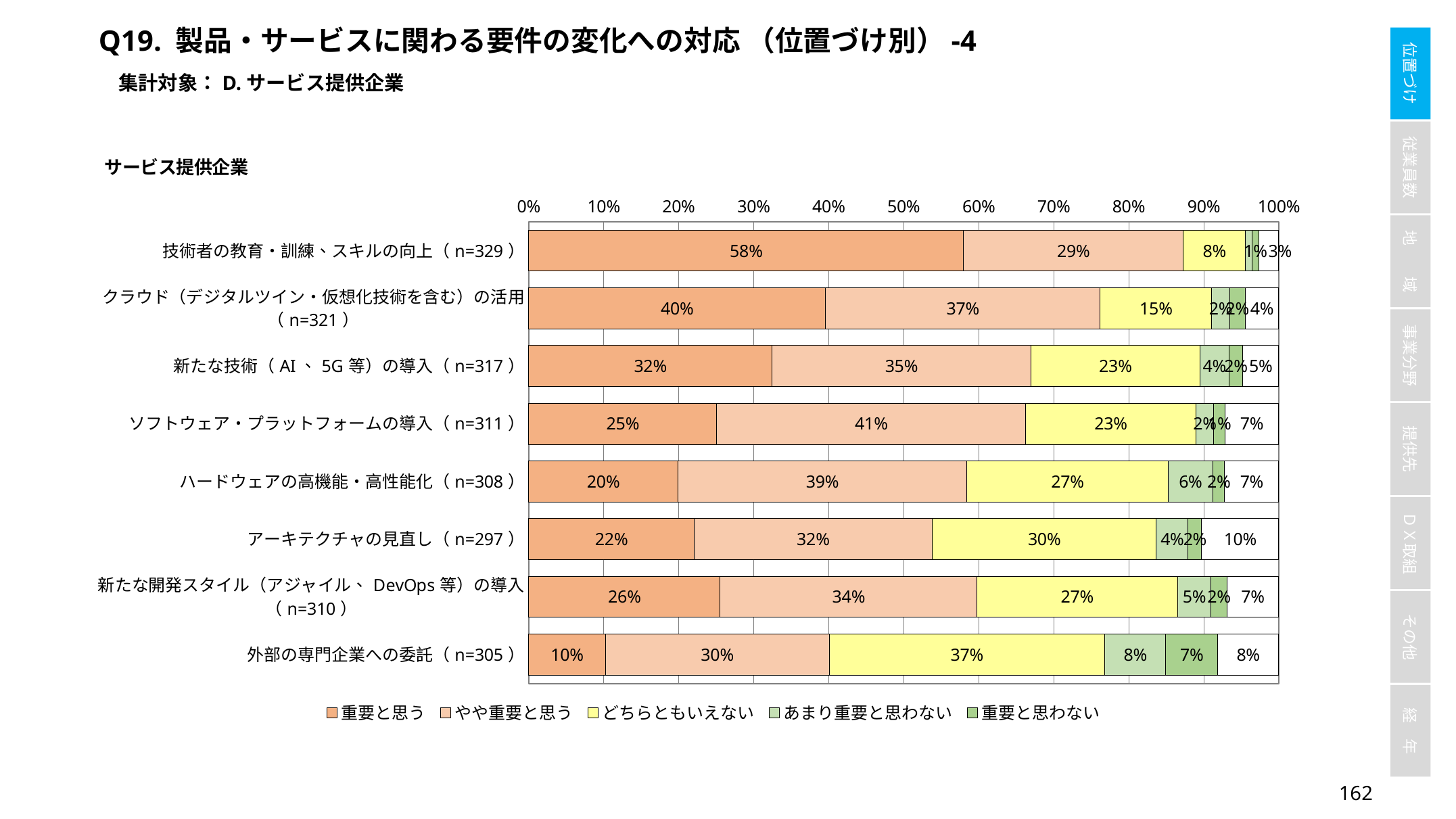
How many series does the legend list? 5 Which category has the lowest value for 重要と思う? 外部の専門企業への委託 What is the difference between the 重要と思う values for 技術者の教育・訓練、スキルの向上 and 外部の専門企業への委託? 48 percentage points Which has a larger 重要と思う value: クラウド（デジタルツイン・仮想化技術を含む）の活用 or 新たな技術（AI、5G等）の導入? クラウド（デジタルツイン・仮想化技術を含む）の活用 Which category has the highest value for どちらともいえない? 外部の専門企業への委託 What is the value of 重要と思う for 技術者の教育・訓練、スキルの向上 (n=329)? 58% Which category has the highest value for 重要と思う? 技術者の教育・訓練、スキルの向上 What is the value of 重要と思わない for 外部の専門企業への委託 (n=305)? 7% What is the value of どちらともいえない for 外部の専門企業への委託 (n=305)? 37% What is the value of やや重要と思う for ソフトウェア・プラットフォームの導入 (n=311)? 41% What kind of chart is shown on the slide? Stacked bar chart How many categories are shown in the chart? 8